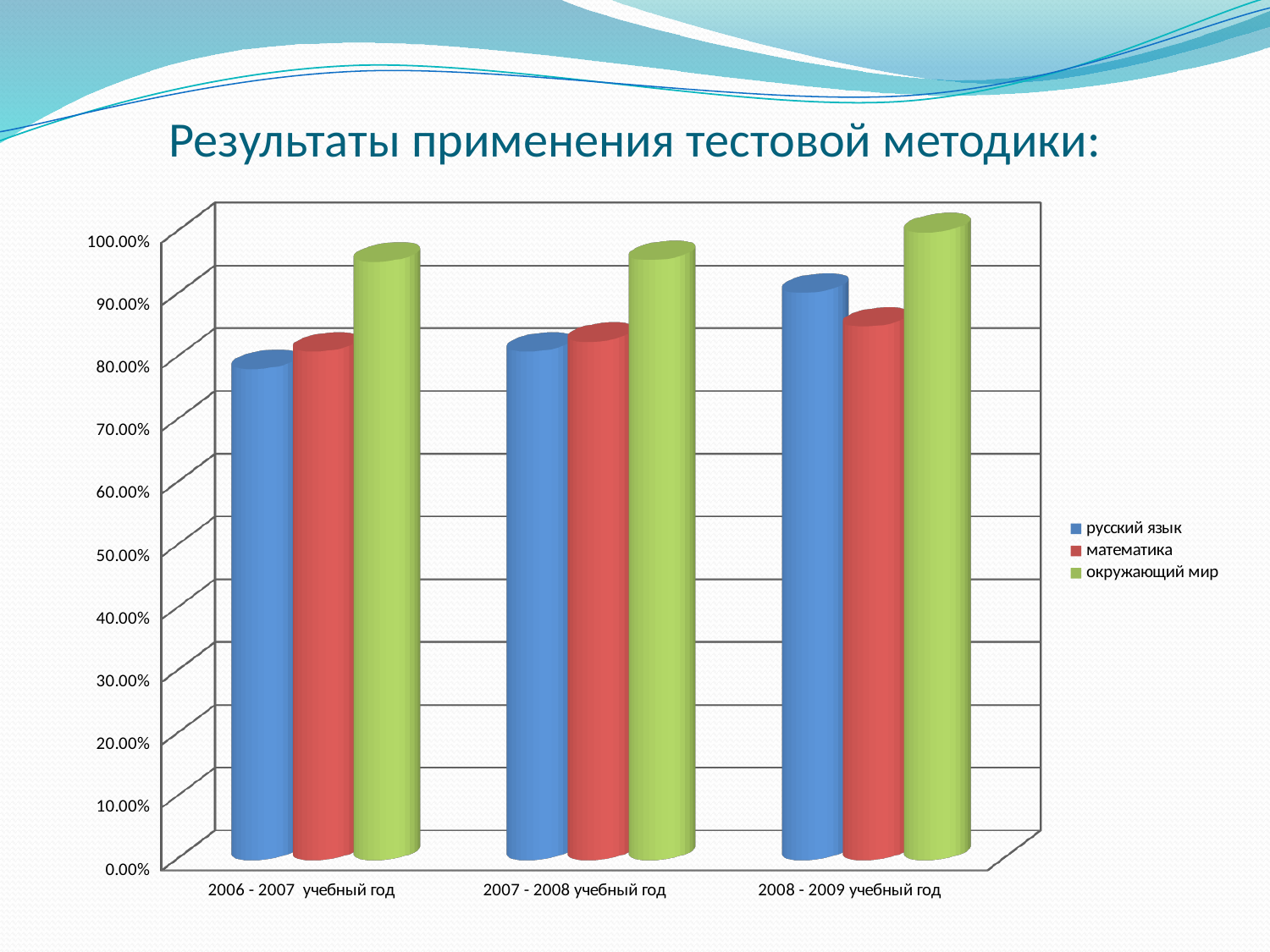
Which series is shown in green in the legend? окружающий мир Do the values for русский язык rise or fall from 2006 - 2007 to 2008 - 2009 учебный год? rise Is the value for математика in 2008 - 2009 учебный год greater or less than 80.00%? greater How many series does the legend list? 3 What is the title of the chart on the slide? Результаты применения тестовой методики: Is the value for окружающий мир in 2006 - 2007 учебный год greater or less than 90.00%? greater How many school-year categories are shown on the x axis? 3 Is the value for русский язык in 2007 - 2008 учебный год greater or less than 70.00%? greater Which subject has the highest value in the 2008 - 2009 учебный год category? окружающий мир Which subject has the lowest value in the 2006 - 2007 учебный год category? русский язык What kind of chart is shown on the slide? bar chart In 2006 - 2007 учебный год, which is larger: the value for русский язык or for окружающий мир? окружающий мир